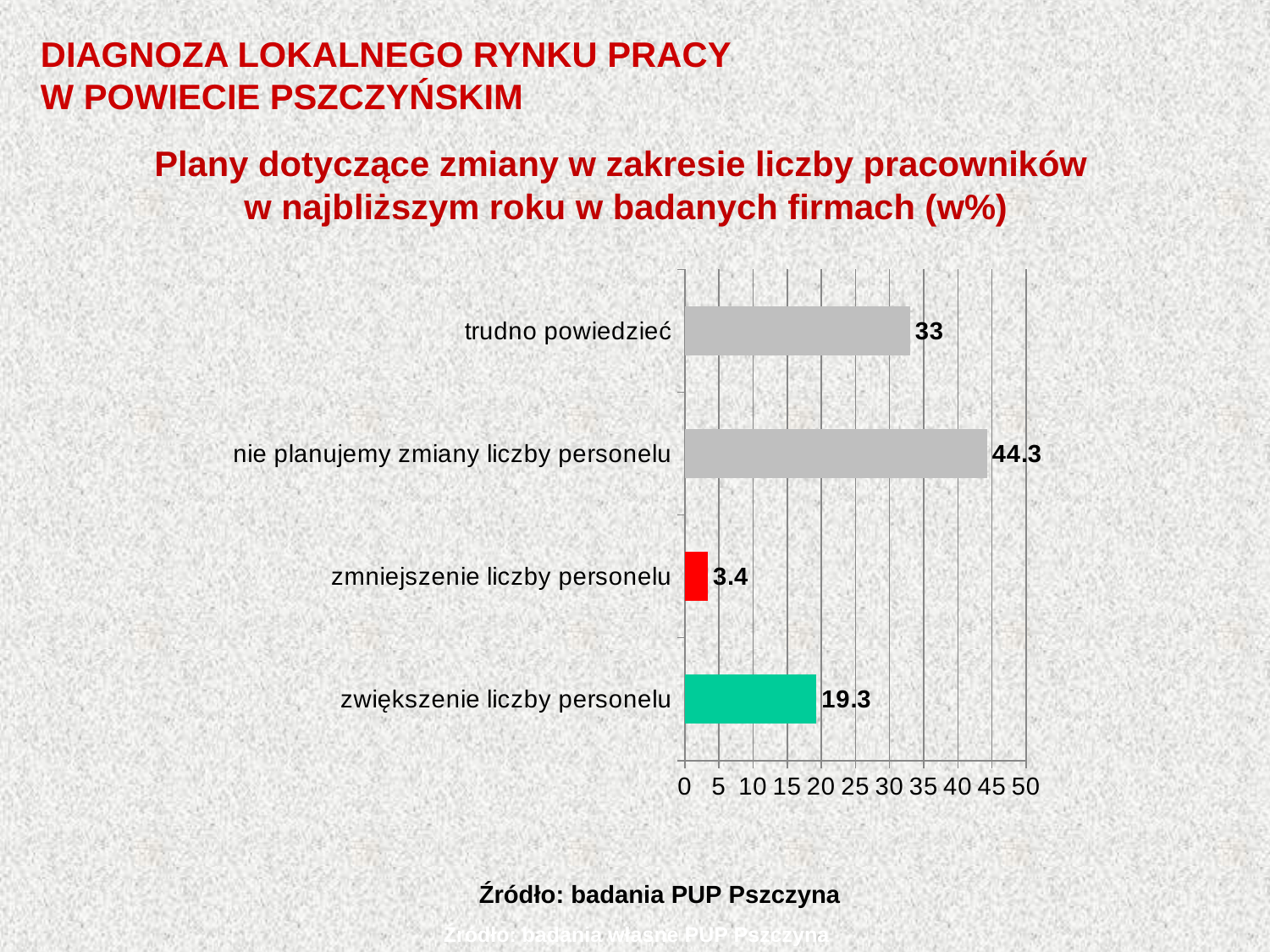
What kind of chart is shown on the slide? bar chart Which is larger: the value for "zwiększenie liczby personelu" or "trudno powiedzieć"? trudno powiedzieć What is the difference between the values for "zwiększenie liczby personelu" and "zmniejszenie liczby personelu"? 15.9 What is the value for "zmniejszenie liczby personelu"? 3.4 Which category has the highest value? nie planujemy zmiany liczby personelu What is the value for "trudno powiedzieć"? 33 What colour is the bar for "zmniejszenie liczby personelu"? red How many categories are shown in the chart? 4 Which category has the lowest value? zmniejszenie liczby personelu What is the difference between the values for "nie planujemy zmiany liczby personelu" and "trudno powiedzieć"? 11.3 What is the value for "nie planujemy zmiany liczby personelu"? 44.3 What is the value for "zwiększenie liczby personelu"? 19.3